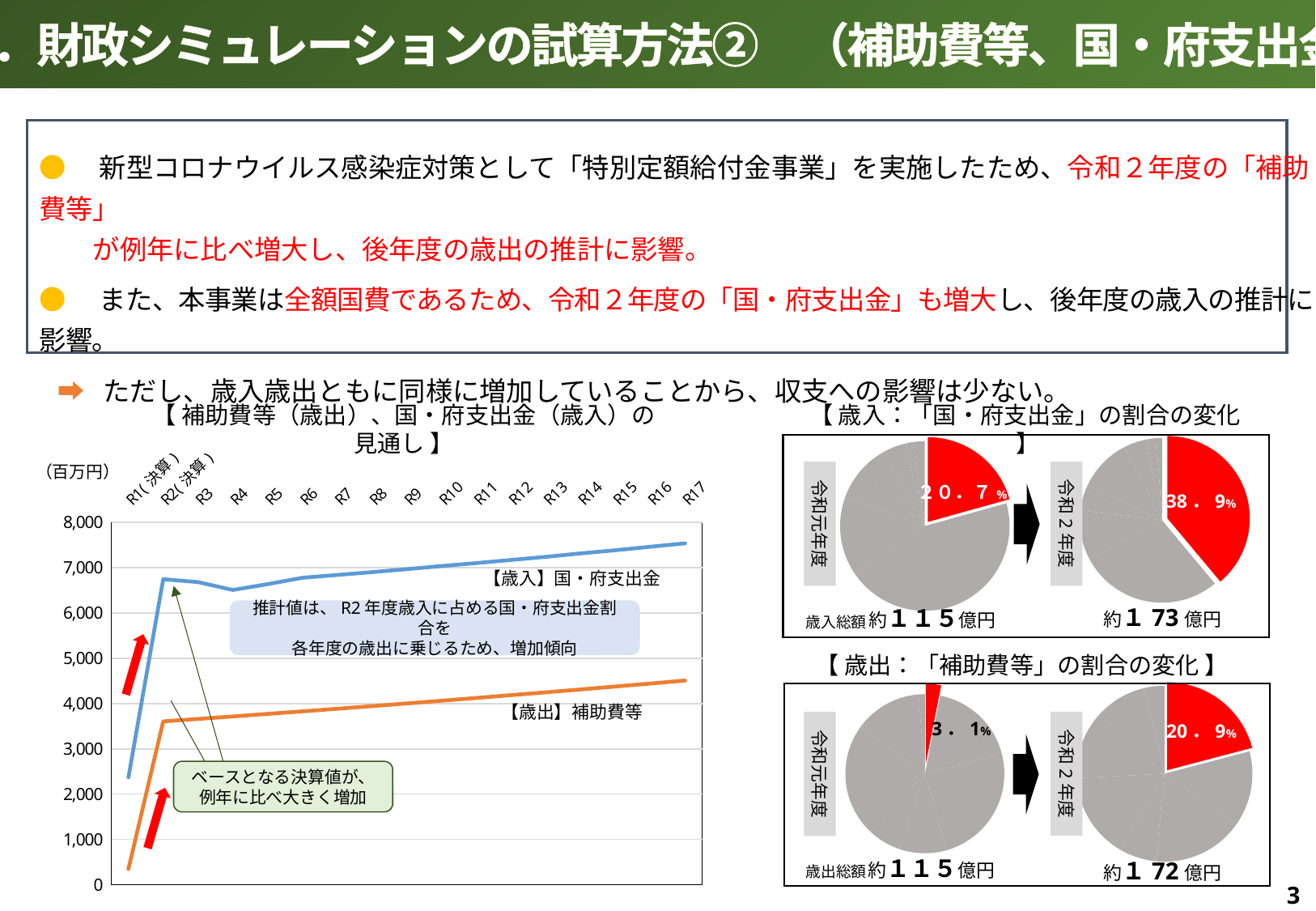
In the left line chart, how many fiscal years are shown on the x axis (R1 to R17)? 17 In the 【歳出：「補助費等」の割合の変化】 pie charts, what share does 補助費等 have in 令和元年度? 3.1% What kind of chart is the left chart titled 【補助費等（歳出）、国・府支出金（歳入）の見通し】? line chart In the left line chart, is the value of 【歳出】補助費等 at R17 greater or less than 4,000? greater In the left line chart, does the 【歳出】補助費等 line rise or fall from R3 to R17? rise In the left line chart, which series is higher at R17, 【歳入】国・府支出金 or 【歳出】補助費等? 【歳入】国・府支出金 In the left line chart, is the value of 【歳出】補助費等 at R1(決算) greater or less than 1,000? less In the 【歳出：「補助費等」の割合の変化】 pie charts, what share does 補助費等 have in 令和2年度? 20.9% In the left line chart, how many series are plotted? 2 In the left line chart, is the value of 【歳入】国・府支出金 at R2(決算) greater or less than 6,000? greater In the 【歳入：「国・府支出金」の割合の変化】 pie charts, what share does 国・府支出金 have in 令和2年度? 38.9%